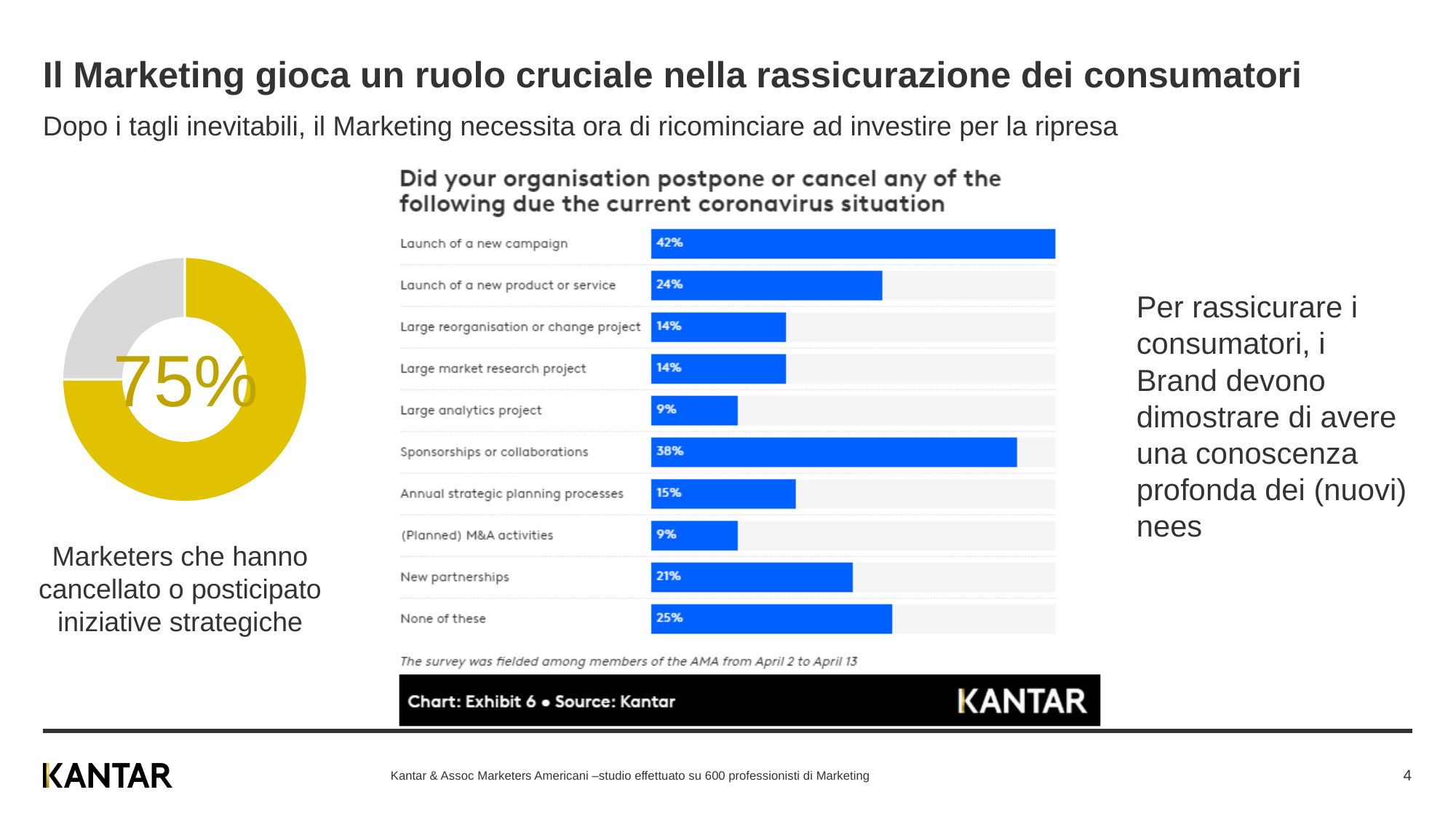
What kind of chart is the chart on the left of the slide showing 75%? Donut chart In the bar chart 'Did your organisation postpone or cancel any of the following due the current coronavirus situation', what is the value for 'Launch of a new campaign'? 42% In the bar chart 'Did your organisation postpone or cancel any of the following due the current coronavirus situation', what is the difference between 'Launch of a new campaign' and 'Launch of a new product or service'? 18% In the bar chart 'Did your organisation postpone or cancel any of the following due the current coronavirus situation', which category has the highest value? Launch of a new campaign In the bar chart 'Did your organisation postpone or cancel any of the following due the current coronavirus situation', which is larger: 'Annual strategic planning processes' or 'New partnerships'? New partnerships What percentage is shown in the donut chart on the left of the slide? 75% In the bar chart 'Did your organisation postpone or cancel any of the following due the current coronavirus situation', what is the lowest value shown? 9% How many categories are shown in the bar chart 'Did your organisation postpone or cancel any of the following due the current coronavirus situation'? 10 In the bar chart 'Did your organisation postpone or cancel any of the following due the current coronavirus situation', what is the value for 'None of these'? 25% In the bar chart 'Did your organisation postpone or cancel any of the following due the current coronavirus situation', what is the value for 'Sponsorships or collaborations'? 38% In the bar chart 'Did your organisation postpone or cancel any of the following due the current coronavirus situation', what is the value for 'New partnerships'? 21% What kind of chart is the chart titled 'Did your organisation postpone or cancel any of the following due the current coronavirus situation'? Bar chart